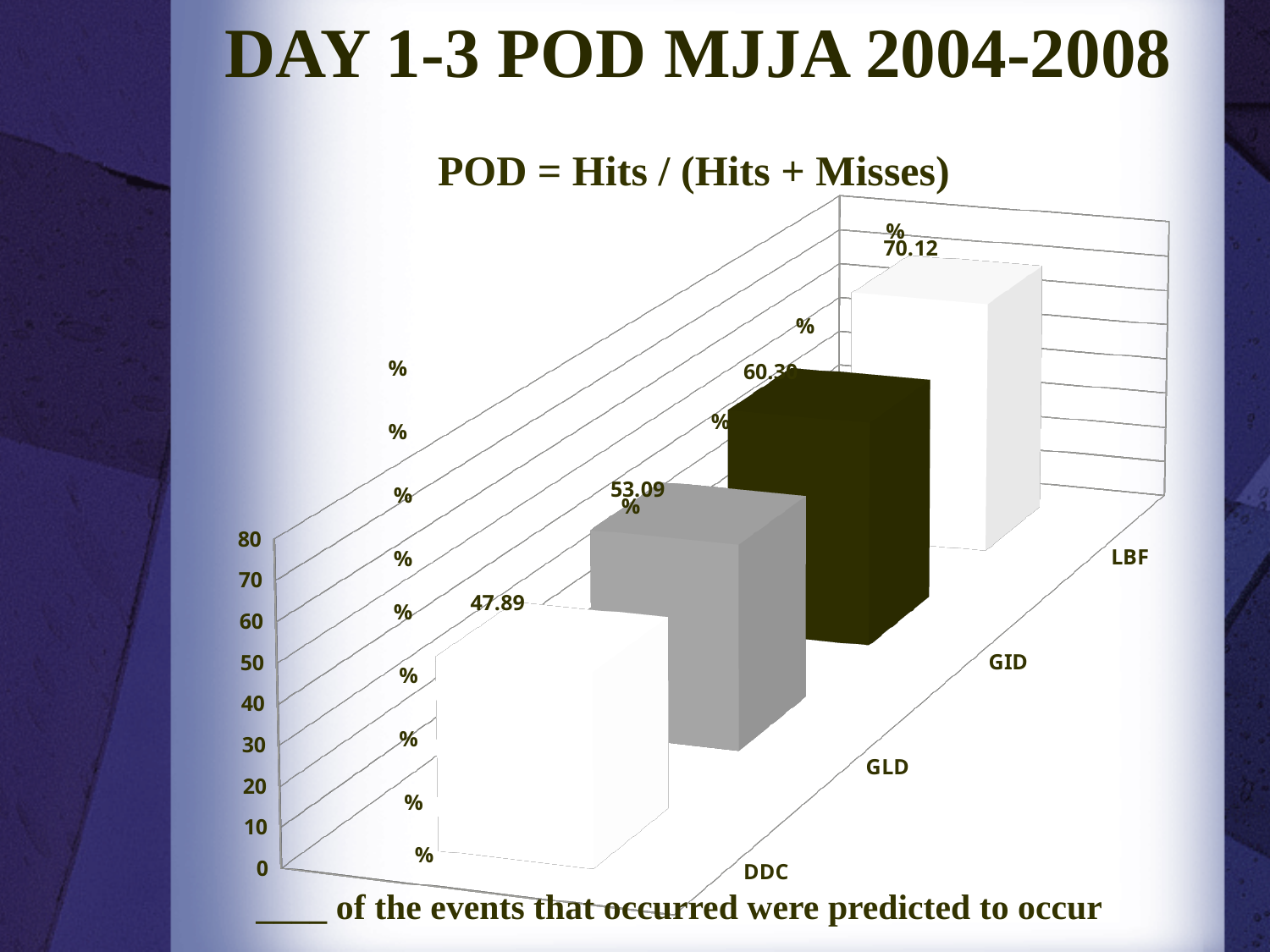
Which site has the highest POD? LBF What is the POD value for LBF? 70.12 Which site has the lowest POD? DDC Do the POD values rise or fall from DDC to LBF along the axis? rise How many sites are shown on the chart? 4 What kind of chart is shown on the slide? bar chart Is the POD value for GID greater or less than 50? greater What is the POD value for GLD? 53.09 What is the difference between the POD values for LBF and DDC? 22.23 Which has a higher POD, GID or GLD? GID What is the POD value for DDC? 47.89 What is the difference between the POD values for GLD and DDC? 5.20